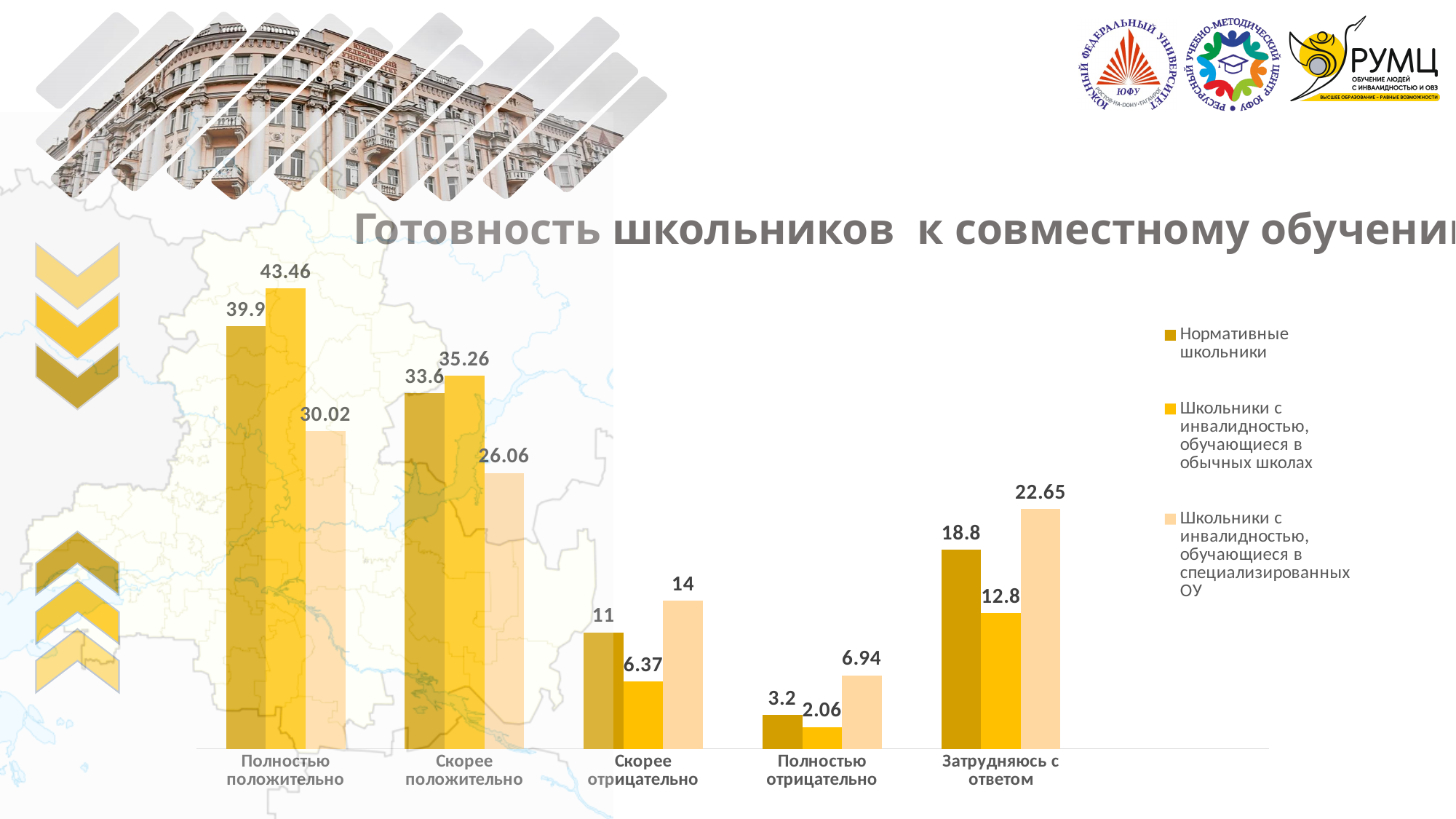
How many series does the legend list? 3 What is the value for "Школьники с инвалидностью, обучающиеся в обычных школах" in the "Полностью отрицательно" category? 2.06 What is the value for "Школьники с инвалидностью, обучающиеся в специализированных ОУ" in the "Затрудняюсь с ответом" category? 22.65 Which category has the lowest value for "Нормативные школьники"? Полностью отрицательно What is the value for "Школьники с инвалидностью, обучающиеся в обычных школах" in the "Полностью положительно" category? 43.46 Which category has the highest value for "Школьники с инвалидностью, обучающиеся в специализированных ОУ"? Полностью положительно What type of chart is shown on the slide? bar chart What is the value for "Нормативные школьники" in the "Полностью положительно" category? 39.9 Which series is shown in the lightest (pale orange) colour in the legend? Школьники с инвалидностью, обучающиеся в специализированных ОУ What is the difference between the "Школьники с инвалидностью, обучающиеся в обычных школах" value and the "Нормативные школьники" value in the "Полностью положительно" category? 3.56 In the "Скорее отрицательно" category, which is larger: the value for "Нормативные школьники" or for "Школьники с инвалидностью, обучающиеся в специализированных ОУ"? Школьники с инвалидностью, обучающиеся в специализированных ОУ How many categories are shown on the x axis? 5